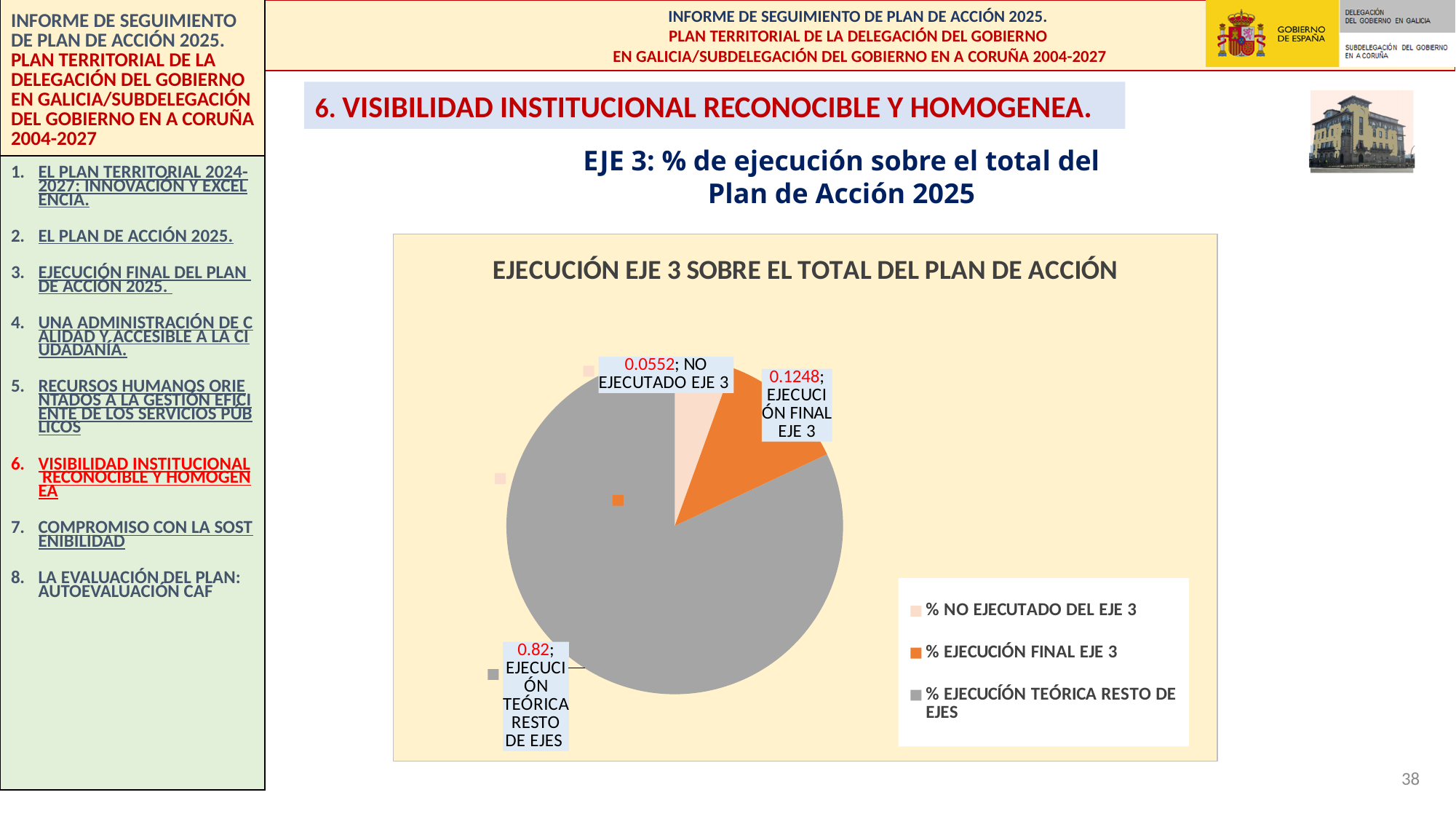
What type of chart is shown on the slide? pie chart What colour is the EJECUCIÓN FINAL EJE 3 slice? orange Which slice of the pie is the largest? EJECUCIÓN TEÓRICA RESTO DE EJES What is the difference between the EJECUCIÓN FINAL EJE 3 value and the NO EJECUTADO EJE 3 value? 0.0696 How many slices does the pie chart have? 3 How many entries does the legend list? 3 What is the value shown for the EJECUCIÓN FINAL EJE 3 slice? 0.1248 What is the value shown for the EJECUCIÓN TEÓRICA RESTO DE EJES slice? 0.82 What is the title of the pie chart? EJECUCIÓN EJE 3 SOBRE EL TOTAL DEL PLAN DE ACCIÓN Which is larger, the EJECUCIÓN FINAL EJE 3 slice or the NO EJECUTADO EJE 3 slice? EJECUCIÓN FINAL EJE 3 Which slice of the pie is the smallest? NO EJECUTADO EJE 3 What is the value shown for the NO EJECUTADO EJE 3 slice? 0.0552